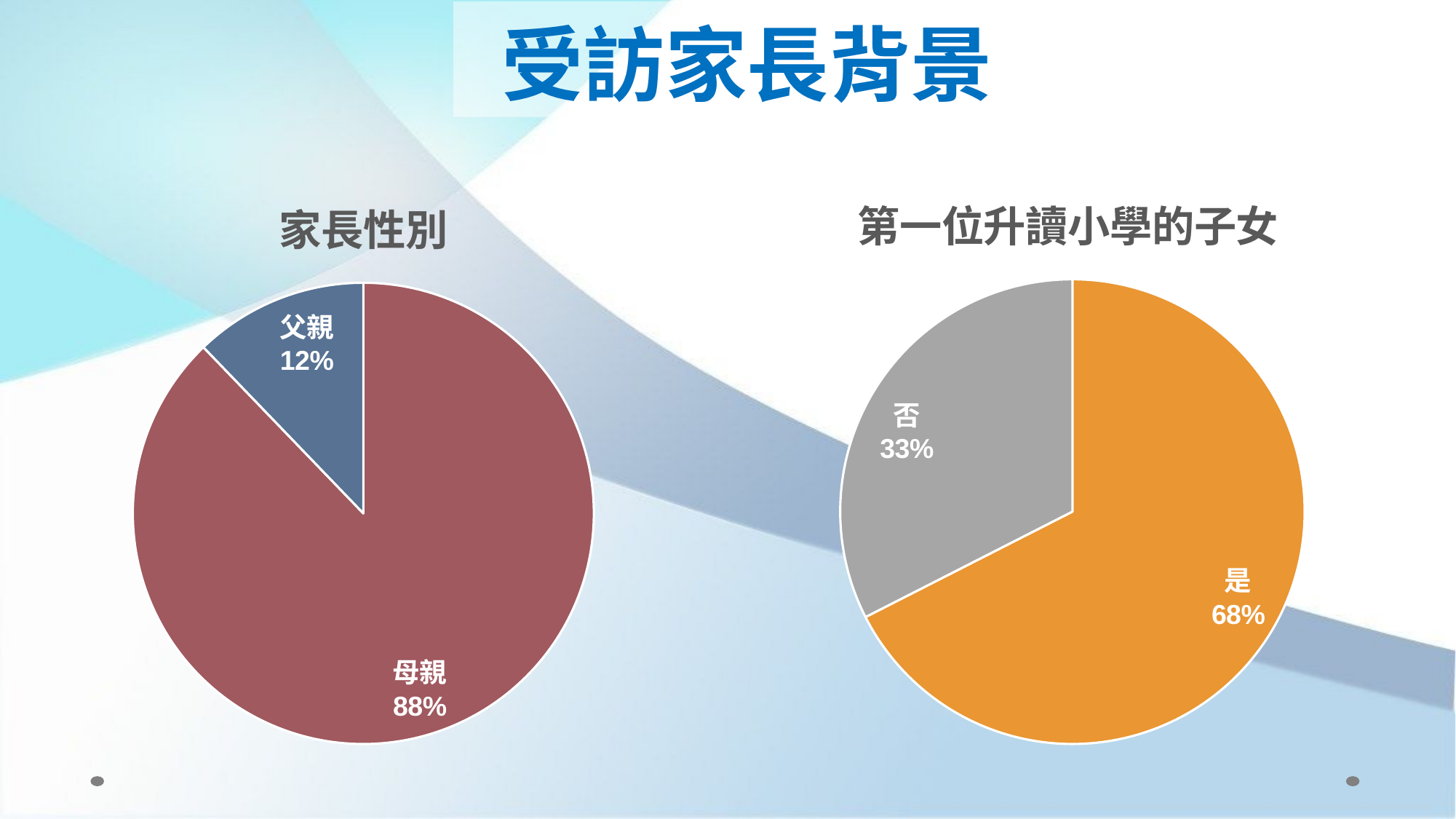
In the 家長性別 chart, what is the difference in percentage points between 母親 and 父親? 76 In the 第一位升讀小學的子女 chart, what percentage is 否? 33% In the 家長性別 chart, what percentage is 母親? 88% In the 第一位升讀小學的子女 chart, which category has the smallest share? 否 In the 第一位升讀小學的子女 chart, what percentage is 是? 68% What kind of chart is the 家長性別 chart? Pie chart In the 家長性別 chart, what percentage is 父親? 12% In the 家長性別 chart, which category has the largest share? 母親 In the 第一位升讀小學的子女 chart, which is larger, 是 or 否? 是 In the 第一位升讀小學的子女 chart, what is the difference in percentage points between 是 and 否? 35 How many slices does the 第一位升讀小學的子女 chart have? 2 What colour is the 是 slice in the 第一位升讀小學的子女 chart? Orange